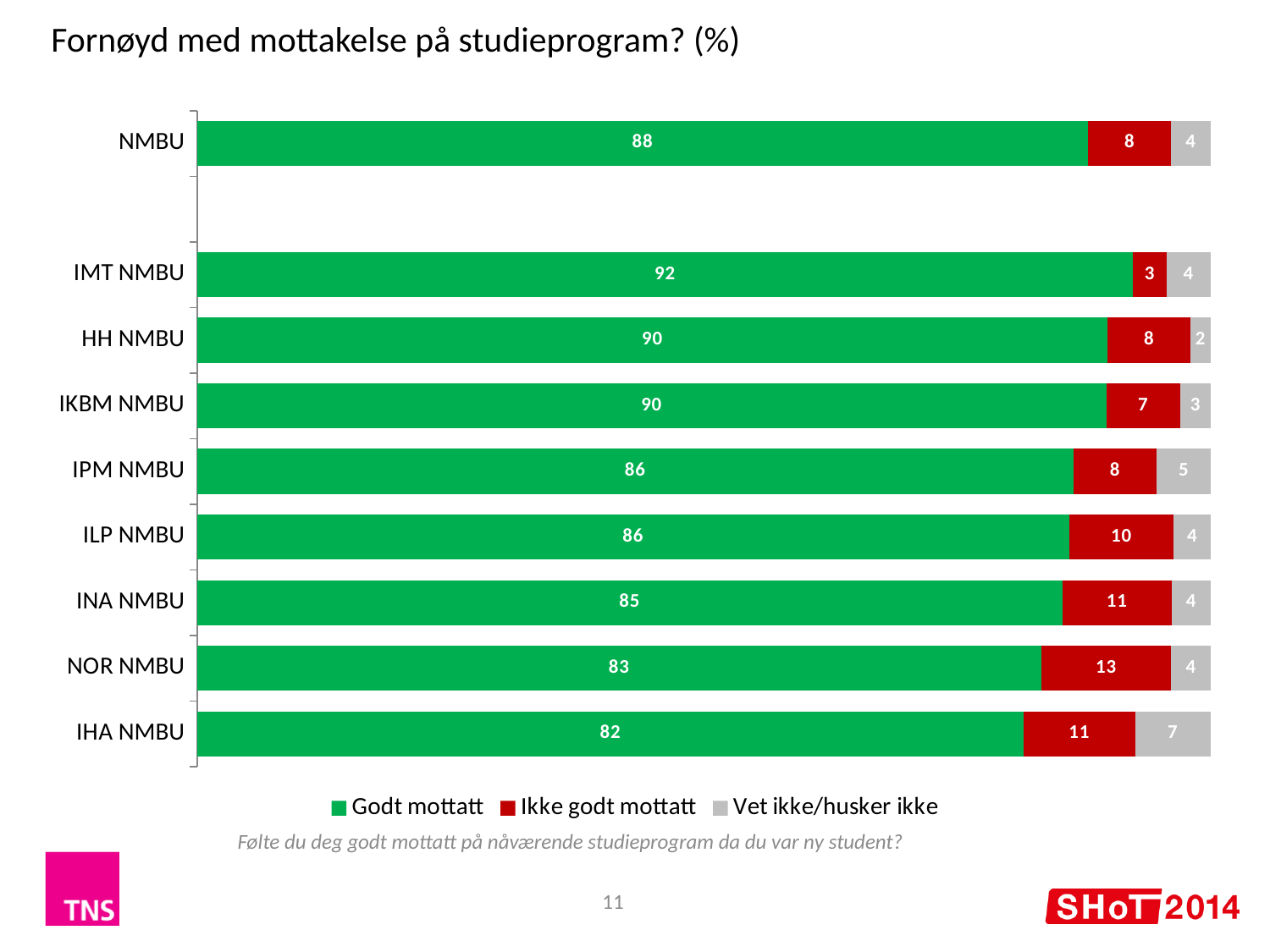
What kind of chart is shown on the slide? Stacked bar chart Which colour represents "Ikke godt mottatt" in the chart? Red What is the value for "Ikke godt mottatt" for NOR NMBU? 13 Which is larger, the "Ikke godt mottatt" value for ILP NMBU or for IPM NMBU? ILP NMBU What is the value for "Vet ikke/husker ikke" for IHA NMBU? 7 How many categories are shown on the chart? 9 Which category has the lowest value for "Godt mottatt"? IHA NMBU What is the difference between the "Godt mottatt" values for NMBU and IHA NMBU? 6 What is the total of the stacked bar for IPM NMBU? 99 How many series does the legend list? 3 Which category has the highest value for "Godt mottatt"? IMT NMBU What is the value for "Godt mottatt" for IMT NMBU? 92